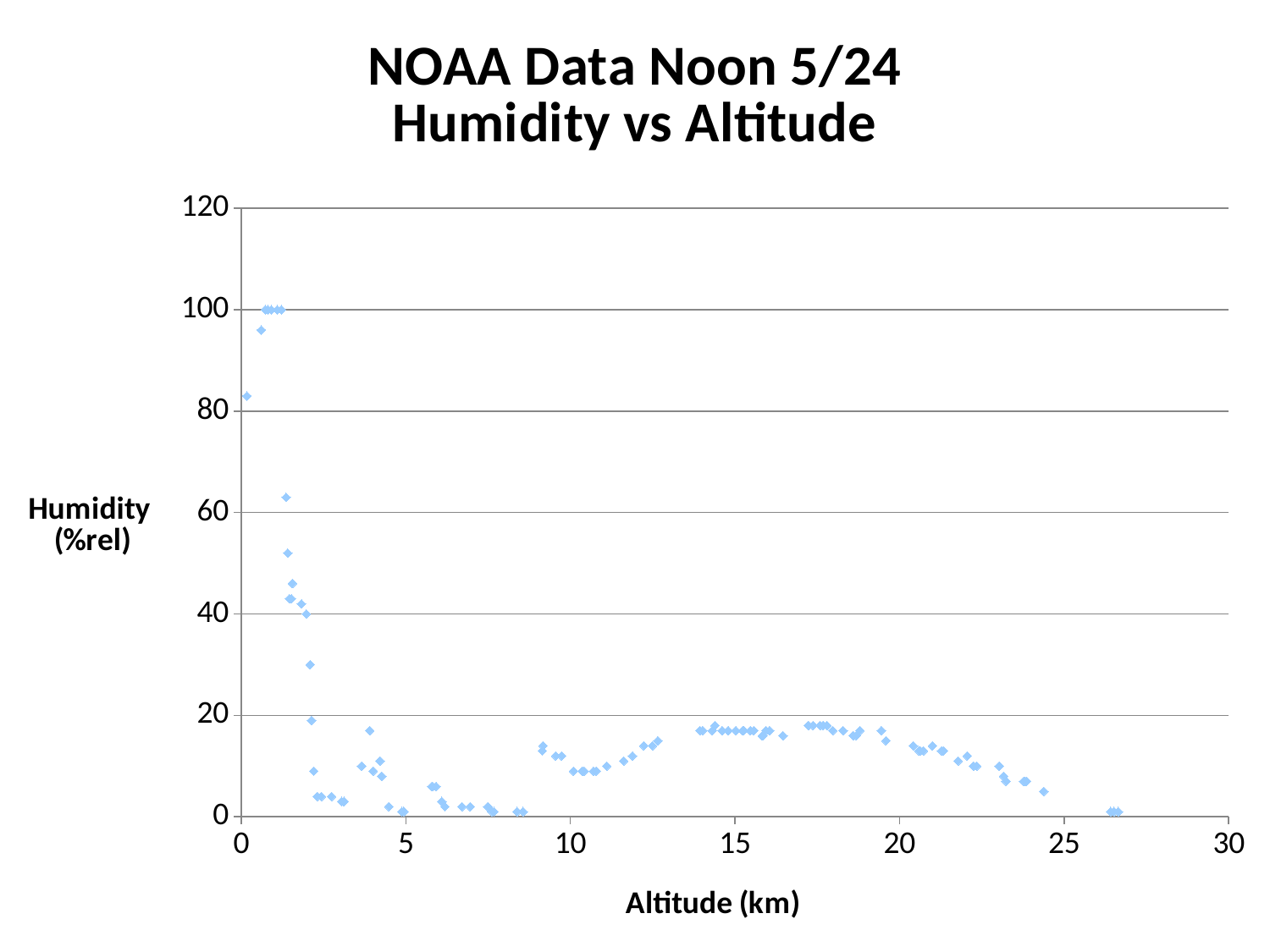
What quantity is plotted on the x axis of the chart? Altitude (km) What kind of chart is shown on the slide? Scatter chart Does humidity generally rise or fall as altitude increases from 0 km to 5 km? Fall Is the humidity at about 5 km altitude greater or less than 20? less Is humidity higher at about 15 km altitude or at about 25 km altitude? About 15 km Are the humidity values plotted between 10 km and 20 km altitude greater or less than 40? less Is the highest humidity value plotted on the chart greater or less than 80? greater Is humidity higher at about 1 km altitude or at about 5 km altitude? About 1 km Does humidity generally rise or fall as altitude increases from 20 km to 25 km? Fall What is the title of the chart? NOAA Data Noon 5/24 Humidity vs Altitude Do the highest humidity values occur at low altitudes or at high altitudes? Low altitudes